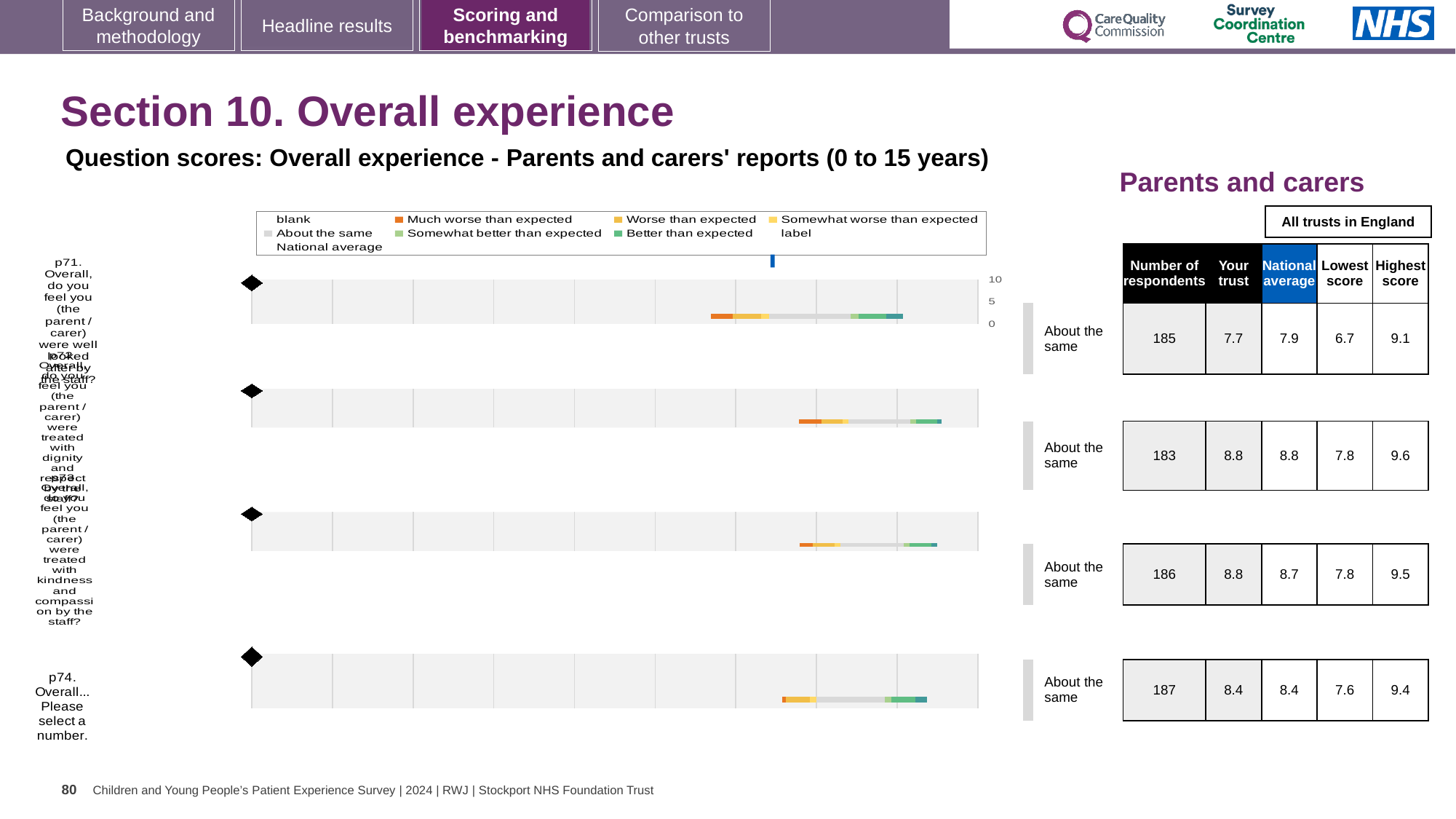
What is the lowest score across all trusts in England for p73? 7.8 How many respondents answered p74 (Overall... Please select a number)? 187 What benchmark category is shown for p74? About the same What is the 'Your trust' score for p71 (Overall, do you feel you were well looked after by the staff?)? 7.7 How many questions (bars) are plotted in the chart? 4 What is the difference between the highest score and the lowest score for p71? 2.4 How many entries does the chart legend list? 9 What is the maximum value shown on the chart's score axis? 10 What kind of chart is used to show the question scores on this slide? Bar chart What is the national average score for p72 (treated with dignity and respect)? 8.8 Which question has the lowest 'Your trust' score? p71 For p73, which is larger: the 'Your trust' score or the national average? Your trust